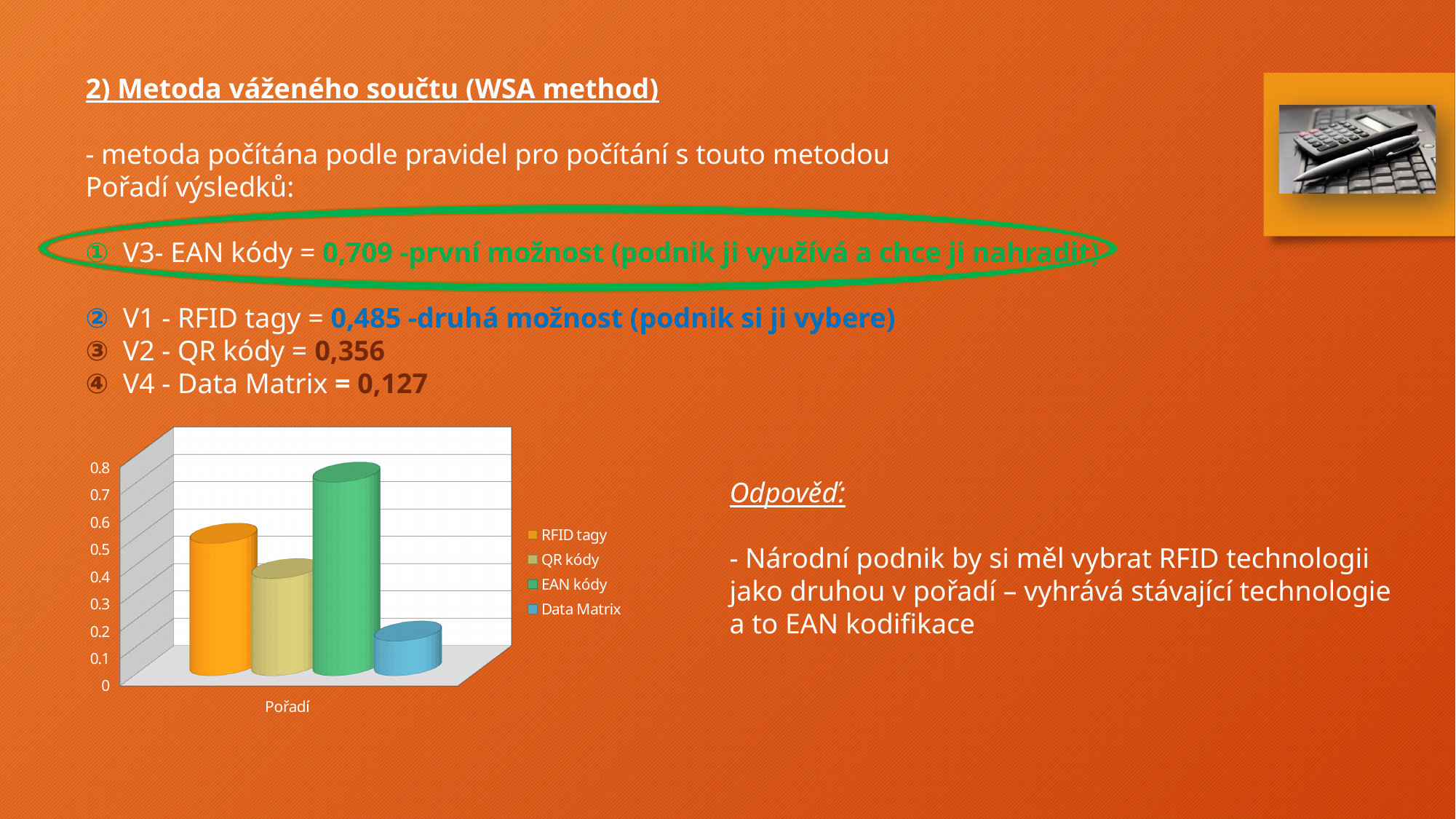
According to the slide, what is the WSA value for Data Matrix? 0,127 How many series does the chart legend list? 4 What kind of chart is shown on the slide? bar chart Which bar is taller, RFID tagy or QR kódy? RFID tagy Is the bar for RFID tagy greater or less than 0.4? greater Which series has the tallest bar in the chart? EAN kódy Which series has the shortest bar in the chart? Data Matrix Is the bar for Data Matrix greater or less than 0.2? less Is the bar for EAN kódy greater or less than 0.6? greater What is the category label shown on the x axis of the chart? Pořadí According to the slide, what is the WSA value for EAN kódy? 0,709